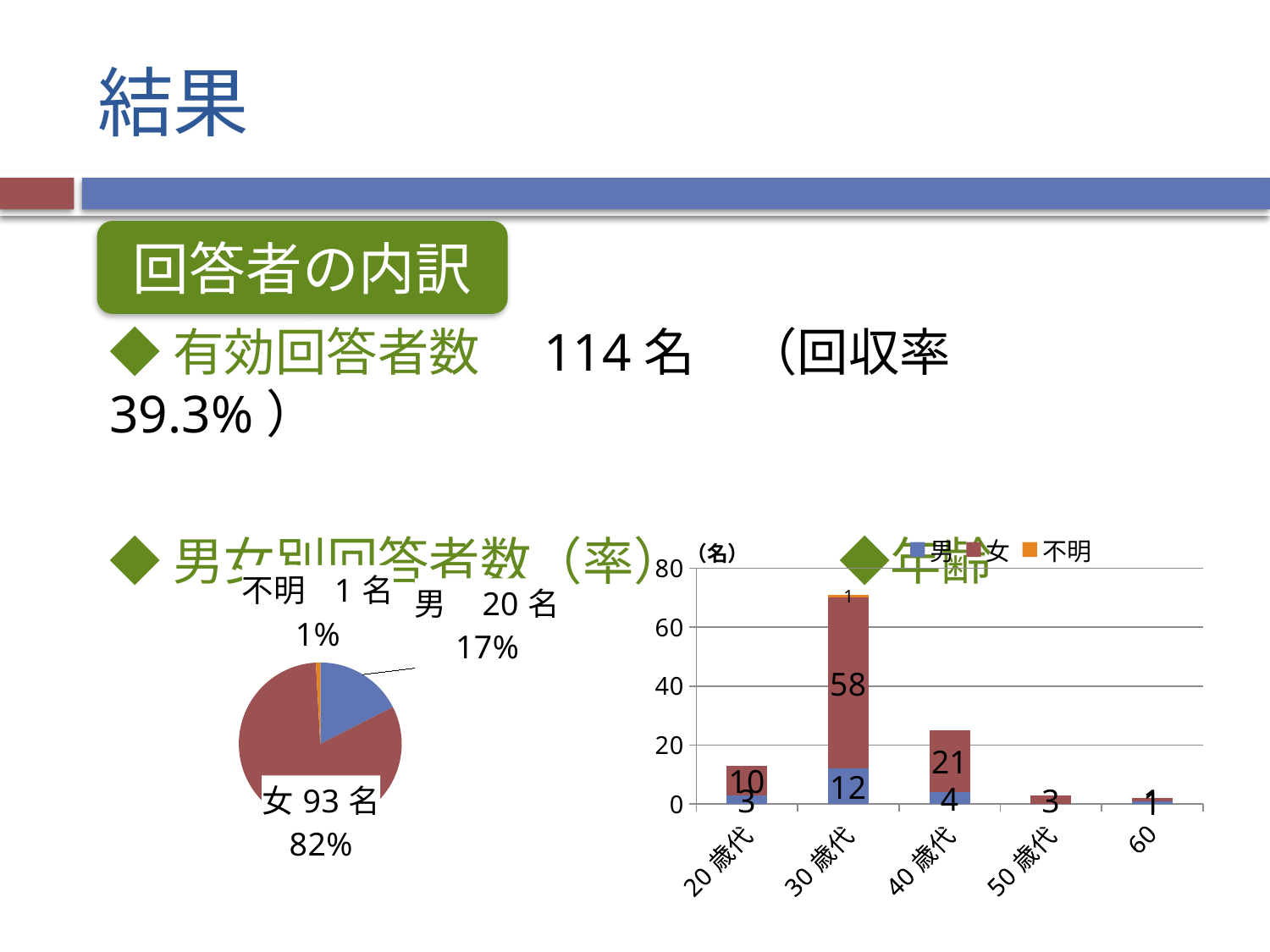
In the 年齢 bar chart on the right, what is the 男 value for 40歳代? 4 What kind of chart is the chart on the left? pie chart In the pie chart on the left, what share of respondents is 女? 82% In the 年齢 bar chart on the right, what is the 女 value for 30歳代? 58 In the pie chart on the left, how many slices are there? 3 In the 年齢 bar chart on the right, which age group has the tallest stacked bar? 30歳代 In the pie chart on the left, how many respondents are 男? 20 名 What kind of chart is the 年齢 chart on the right? bar chart In the 年齢 bar chart on the right, what is the difference between the 女 values for 30歳代 and 40歳代? 37 In the 年齢 bar chart on the right, what is the total of the stacked bar for 30歳代? 71 In the 年齢 bar chart on the right, how many series does the legend list? 3 In the 年齢 bar chart on the right, is the total for 30歳代 greater or less than 60? greater